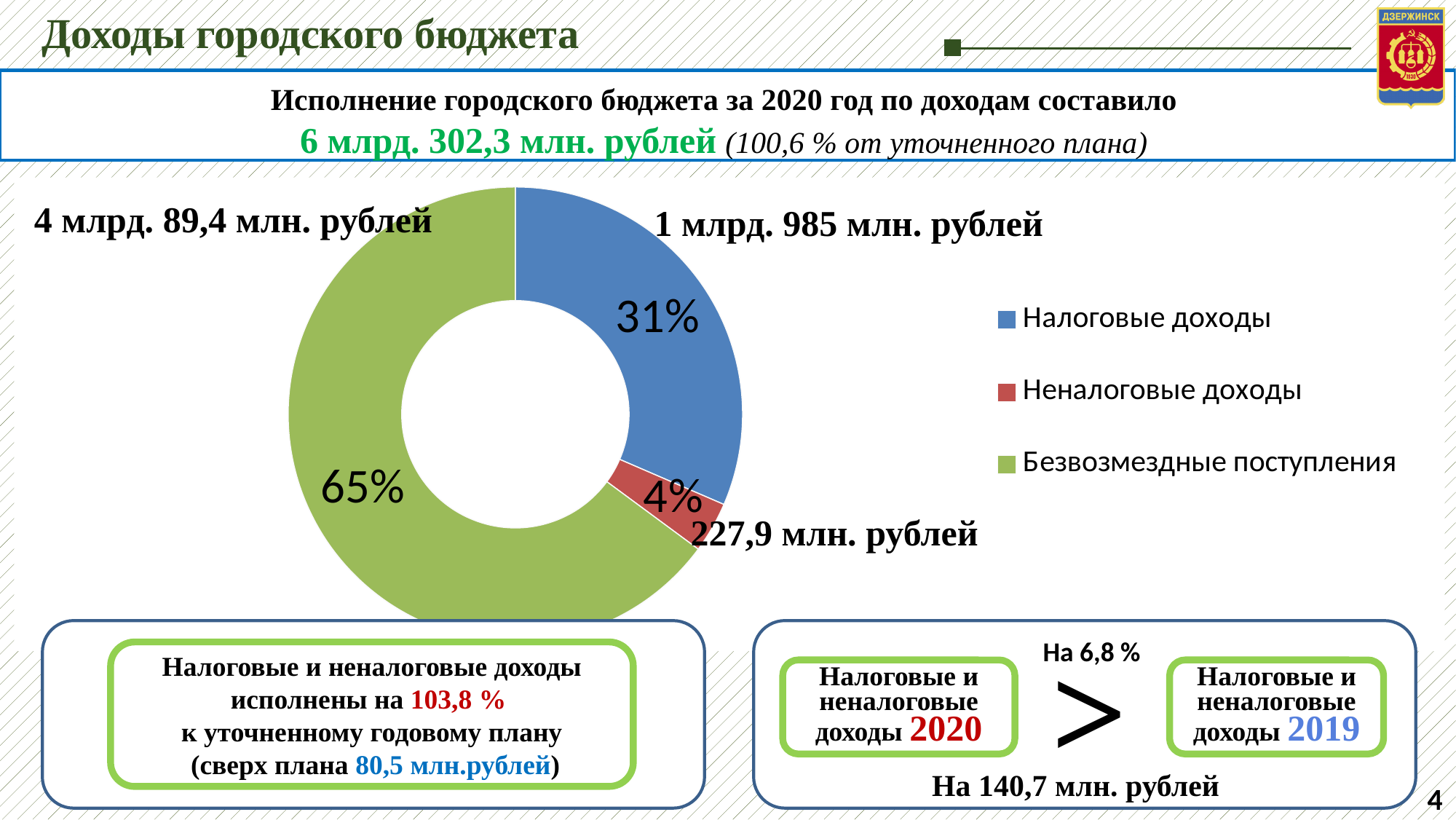
What share of the city budget revenue comes from Неналоговые доходы? 4% Which category has the smallest share of the chart? Неналоговые доходы By how many percentage points does the share of Безвозмездные поступления exceed the share of Налоговые доходы? 34% What type of chart is shown on the slide? Pie (doughnut) chart How many categories does the chart show? 3 Which category has the largest share of the chart? Безвозмездные поступления What share of the city budget revenue comes from Налоговые доходы? 31% What is the amount shown for Безвозмездные поступления? 4 млрд. 89,4 млн. рублей What is the amount shown for Налоговые доходы? 1 млрд. 985 млн. рублей What is the amount shown for Неналоговые доходы? 227,9 млн. рублей What share of the city budget revenue comes from Безвозмездные поступления? 65% Which is larger: the share of Налоговые доходы or the share of Неналоговые доходы? Налоговые доходы